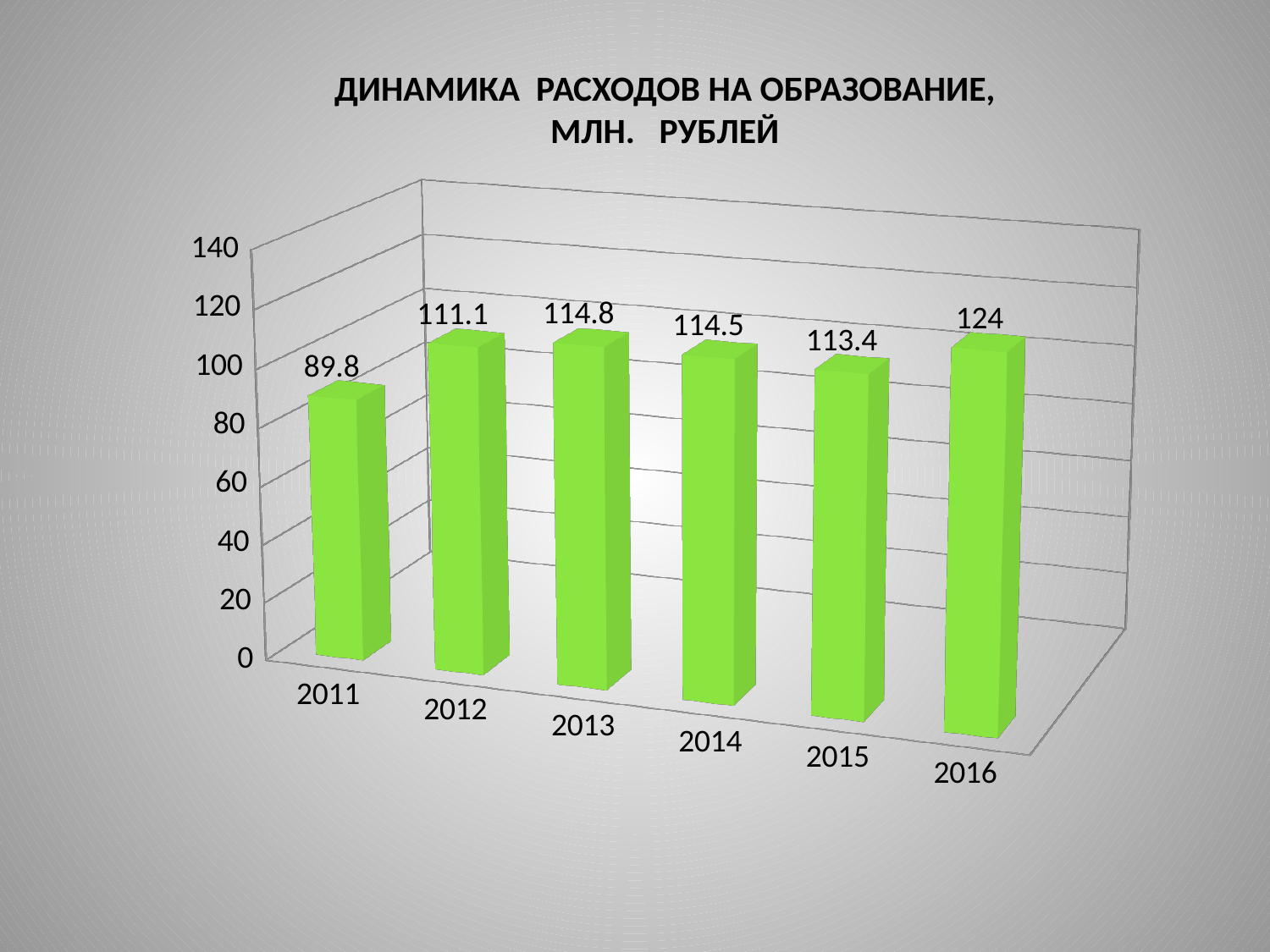
Which is larger, the value for 2012 or the value for 2015? 2015 What is the difference between the values for 2016 and 2011? 34.2 What is the difference between the values for 2013 and 2012? 3.7 Which year has the highest value? 2016 What kind of chart is this? bar chart What is the value for 2011? 89.8 What is the value for 2014? 114.5 Is the value for 2011 greater or less than 100? less Which year has the lowest value? 2011 What is the value for 2016? 124 How many years are shown on the x axis? 6 What is the title of the chart? ДИНАМИКА РАСХОДОВ НА ОБРАЗОВАНИЕ, МЛН. РУБЛЕЙ